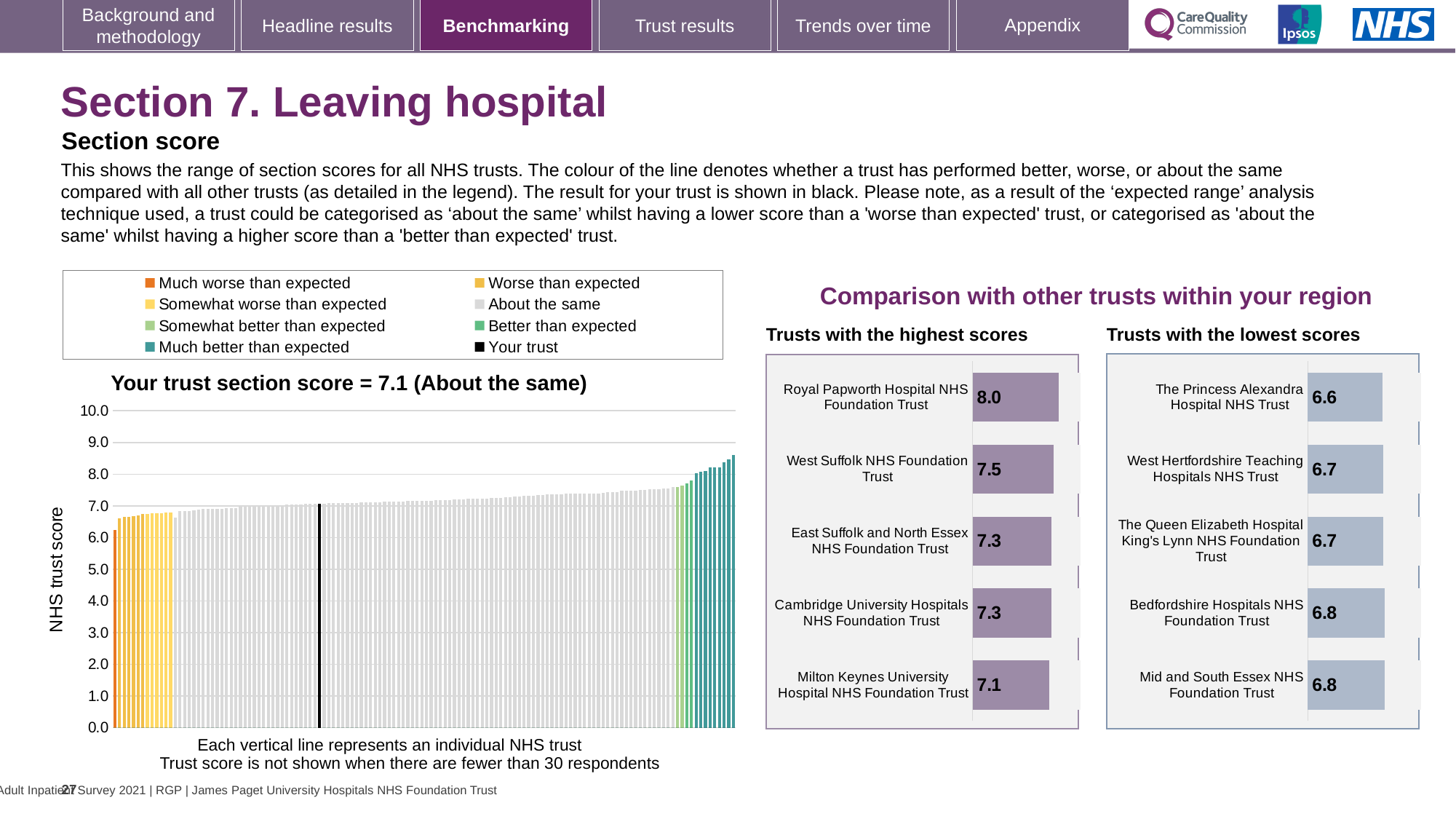
How many trusts are listed in the 'Trusts with the lowest scores' chart? 5 According to the main chart's title, what is your trust's section score? 7.1 How many entries does the legend of the main section score chart on the left list? 8 In the 'Trusts with the lowest scores' chart, what is the difference between the scores of Bedfordshire Hospitals NHS Foundation Trust and The Princess Alexandra Hospital NHS Trust? 0.2 In the 'Trusts with the highest scores' chart, which has the larger score: West Suffolk NHS Foundation Trust or Cambridge University Hospitals NHS Foundation Trust? West Suffolk NHS Foundation Trust In the 'Trusts with the highest scores' chart, what is the difference between the scores of Royal Papworth Hospital NHS Foundation Trust and Milton Keynes University Hospital NHS Foundation Trust? 0.9 What kind of chart is the main section score chart on the left of the slide? Bar chart In the 'Trusts with the lowest scores' chart, what is the score for The Princess Alexandra Hospital NHS Trust? 6.6 In the 'Trusts with the highest scores' chart, which trust has the highest score? Royal Papworth Hospital NHS Foundation Trust In the main section score chart on the left, do the trust scores rise or fall from left to right along the x axis? Rise In the 'Trusts with the highest scores' chart, what is the score for Royal Papworth Hospital NHS Foundation Trust? 8.0 In the 'Trusts with the lowest scores' chart, which trust has the lowest score? The Princess Alexandra Hospital NHS Trust